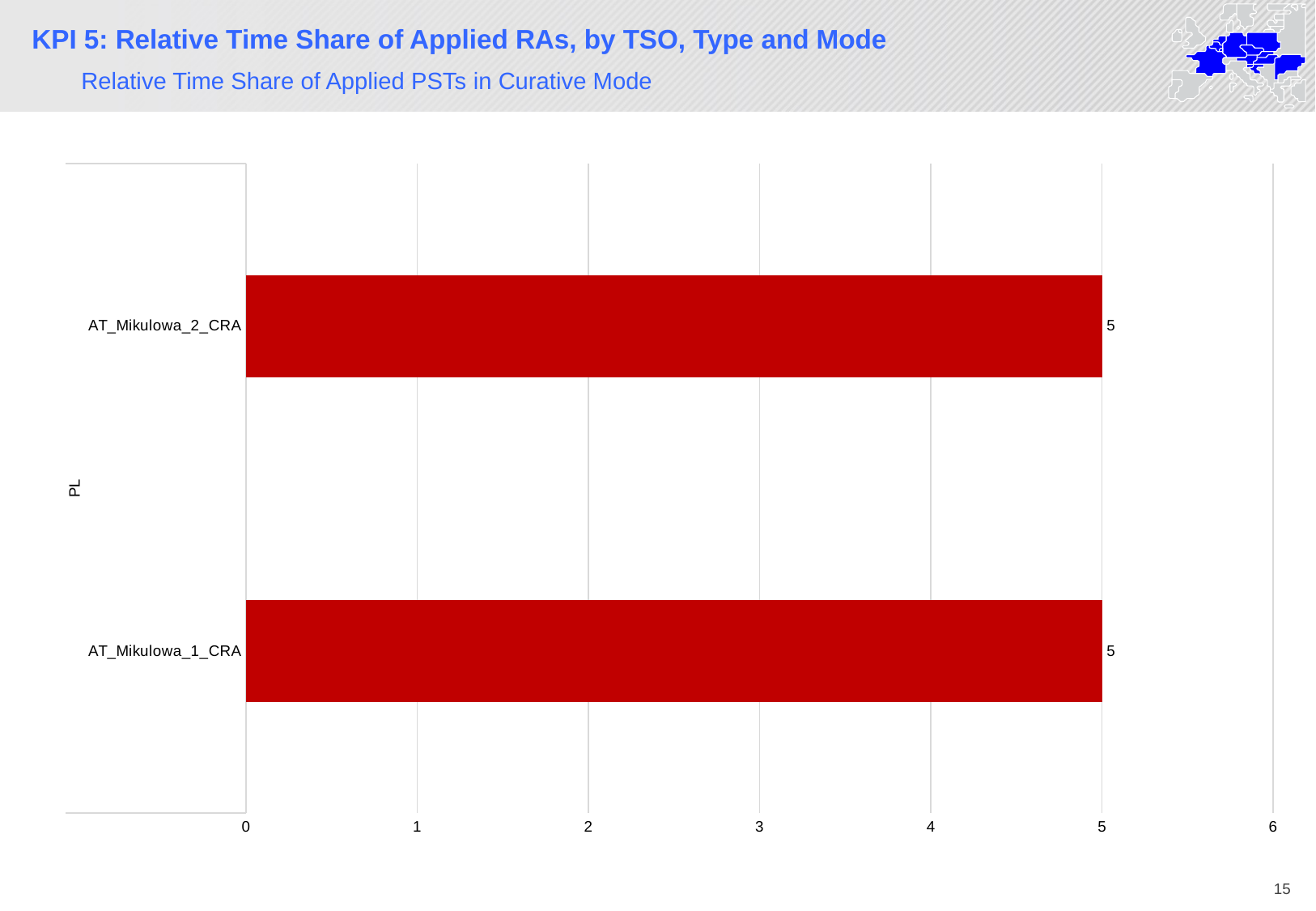
What is the highest value shown on the horizontal axis? 6 What is the subtitle of the chart on the slide? Relative Time Share of Applied PSTs in Curative Mode How many categories are plotted in the chart? 2 What is the value for AT_Mikulowa_1_CRA? 5 What kind of chart is shown on the slide? bar chart Is the value for AT_Mikulowa_1_CRA greater or less than 3? greater What is the value for AT_Mikulowa_2_CRA? 5 What is the difference between the values for AT_Mikulowa_2_CRA and AT_Mikulowa_1_CRA? 0 Is the value for AT_Mikulowa_2_CRA greater or less than 6? less What label is shown on the vertical axis of the chart? PL